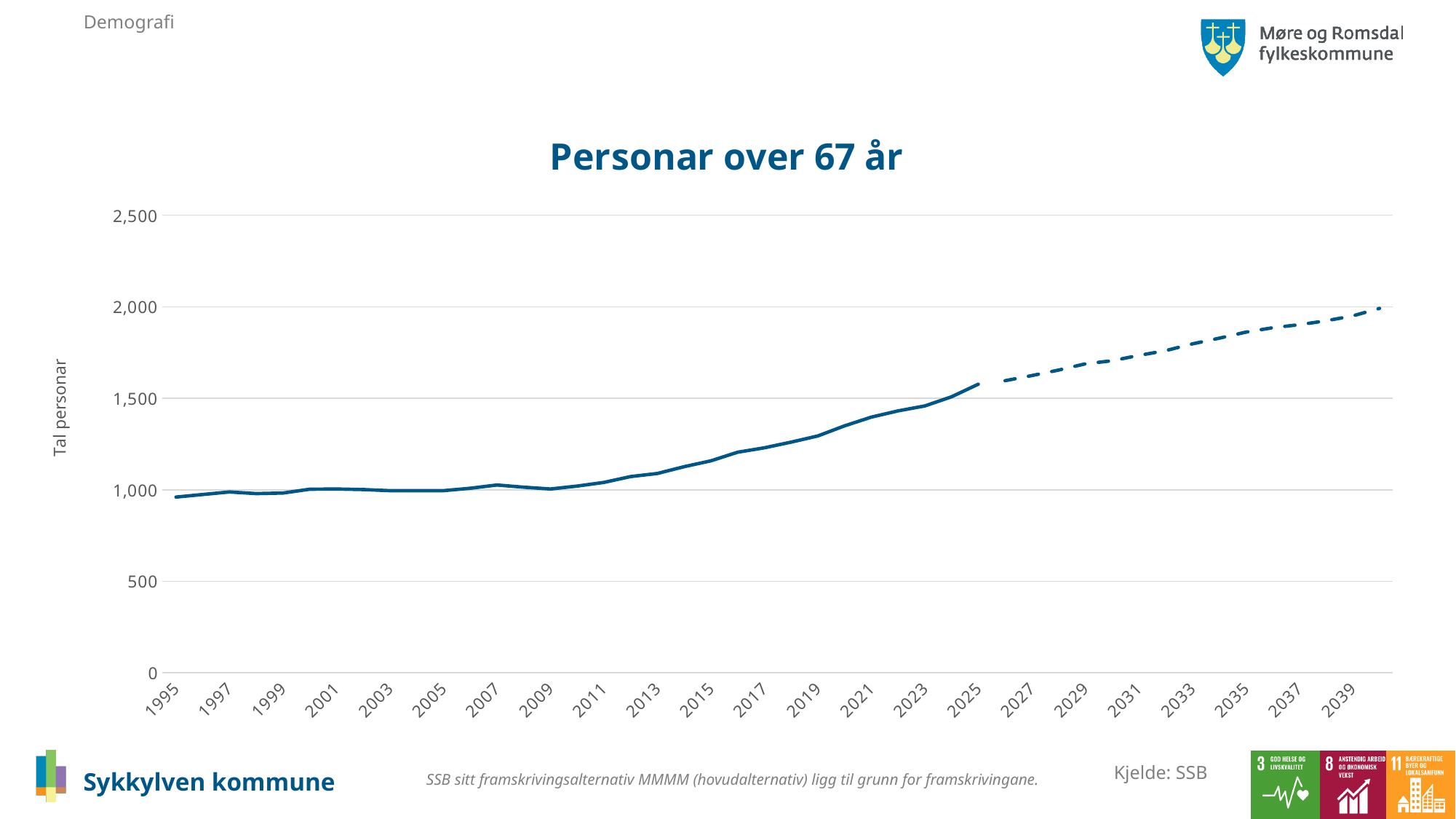
Which year has the lowest value on the chart? 1995 Is the value for 2019 greater or less than 1,500? less Is the value for 1995 greater or less than 1,000? less Is the value for 2017 greater or less than 1,000? greater Do the values generally rise or fall from 1995 to 2039? rise What kind of chart is shown on the slide? line chart What is the title of the chart? Personar over 67 år What is the label on the vertical axis of the chart? Tal personar Which is larger, the value for 2005 or the value for 2025? 2025